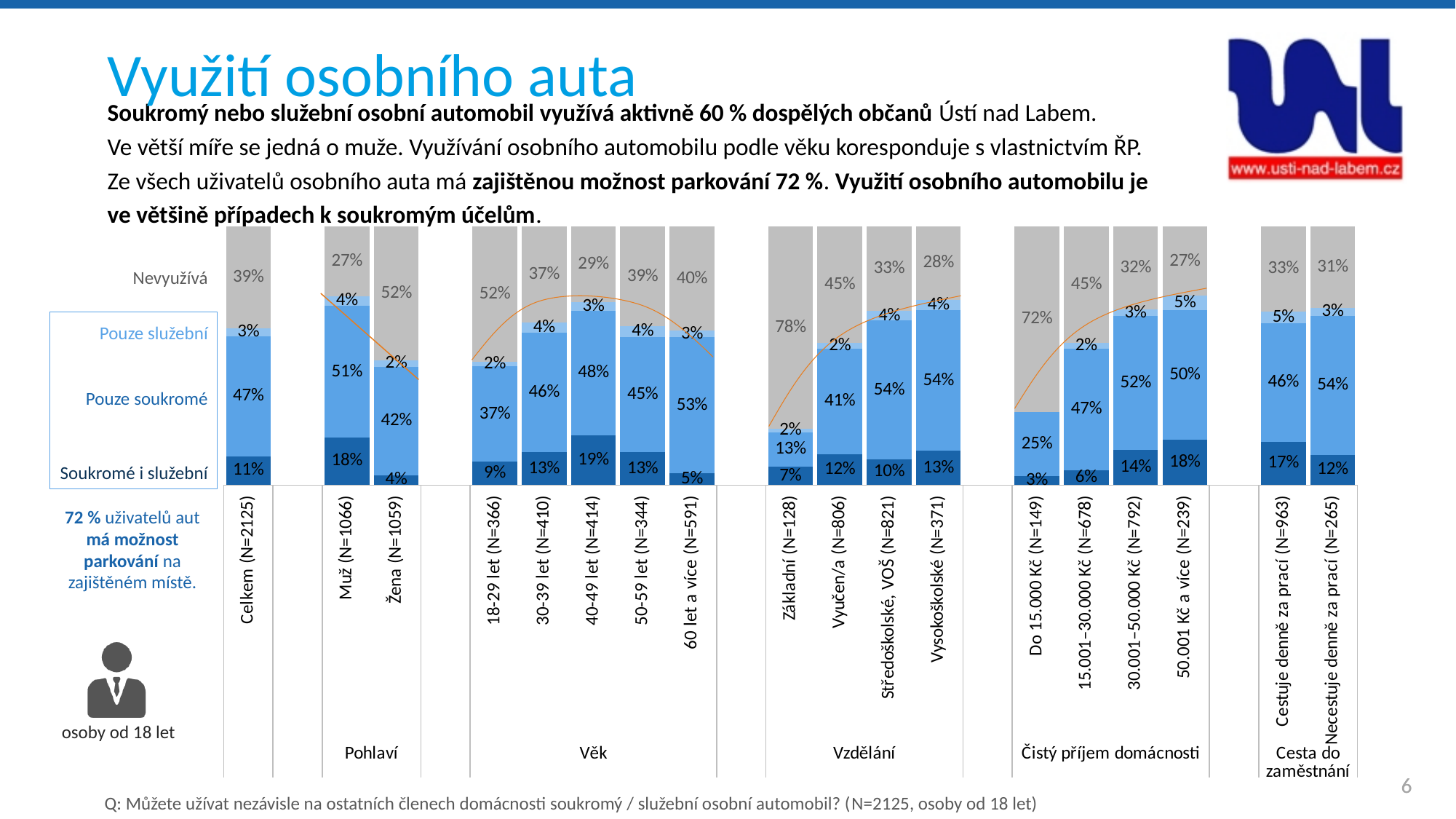
What kind of chart is shown on the slide? Stacked bar chart How many bars (categories) are plotted in the chart? 18 How many series does the legend list? 4 Which has a larger Pouze soukromé share: Cestuje denně za prací (N=963) or Necestuje denně za prací (N=265)? Necestuje denně za prací (N=265) Which age group has the lowest Soukromé i služební share? 60 let a více (N=591) What is the Soukromé i služební value for 40-49 let (N=414)? 19% What is the Pouze soukromé value for Muž (N=1066)? 51% Which category has the highest Nevyužívá share? Základní (N=128) What is the total of the stacked bar for Celkem (N=2125)? 100% What percentage of the Celkem (N=2125) group is in the Nevyužívá category? 39% What is the difference between the Nevyužívá values for Žena (N=1059) and Muž (N=1066)? 25 percentage points Which series is shown in grey at the top of each bar? Nevyužívá